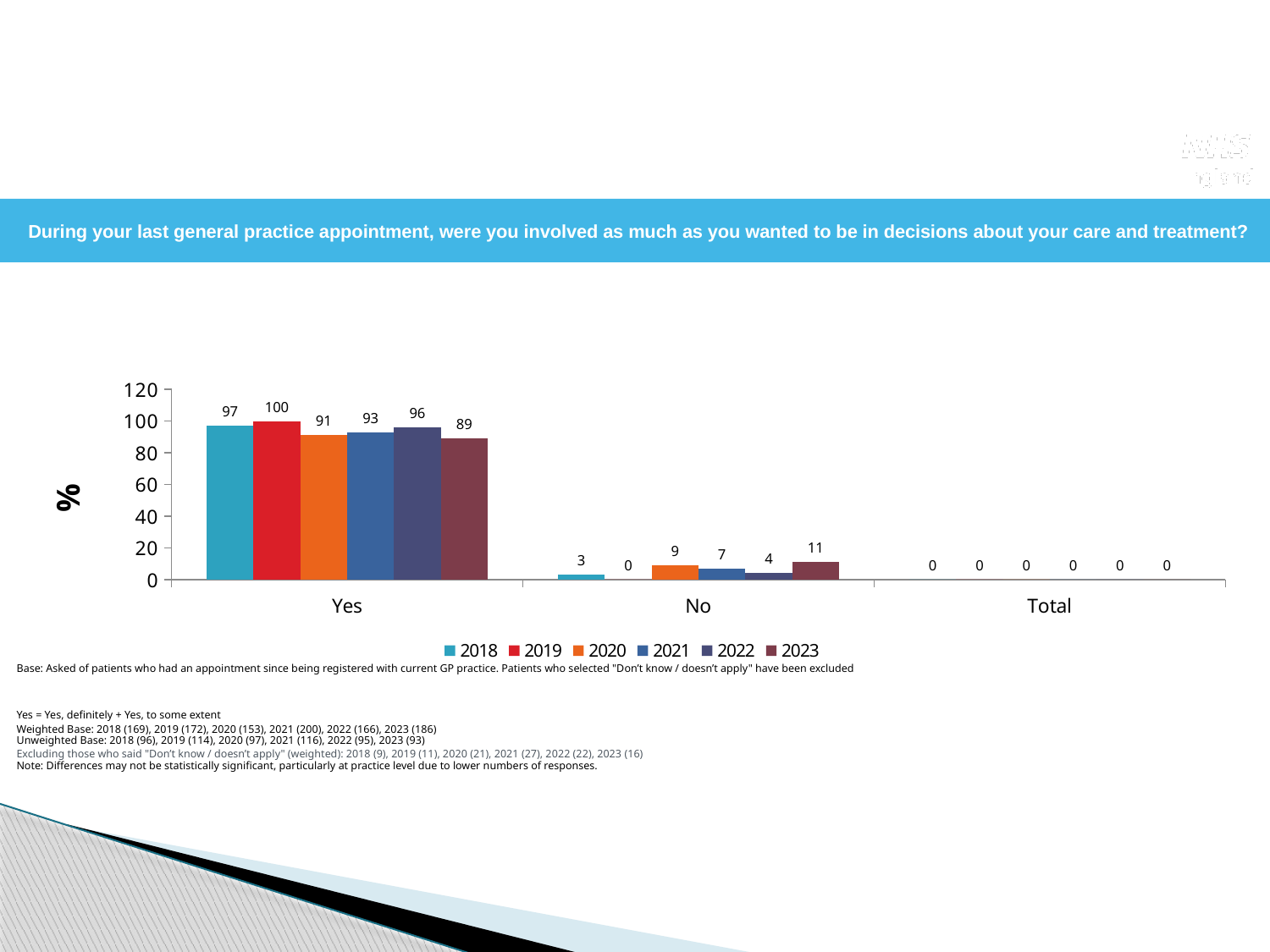
Which year has the lowest value in the Yes category? 2023 What is the value for 2023 in the No category? 11 How many series does the legend list? 6 Which year has the lowest value in the No category? 2019 What kind of chart is shown on the slide? Bar chart What is the difference between the 2019 and 2023 values in the Yes category? 11 Which is larger: the 2021 value for Yes or the 2022 value for Yes? 2022 What is the value for 2020 in the Yes category? 91 Which year has the highest value in the Yes category? 2019 What is the value for 2019 in the Yes category? 100 What is the label on the vertical axis? % How many categories are shown on the x axis? 3